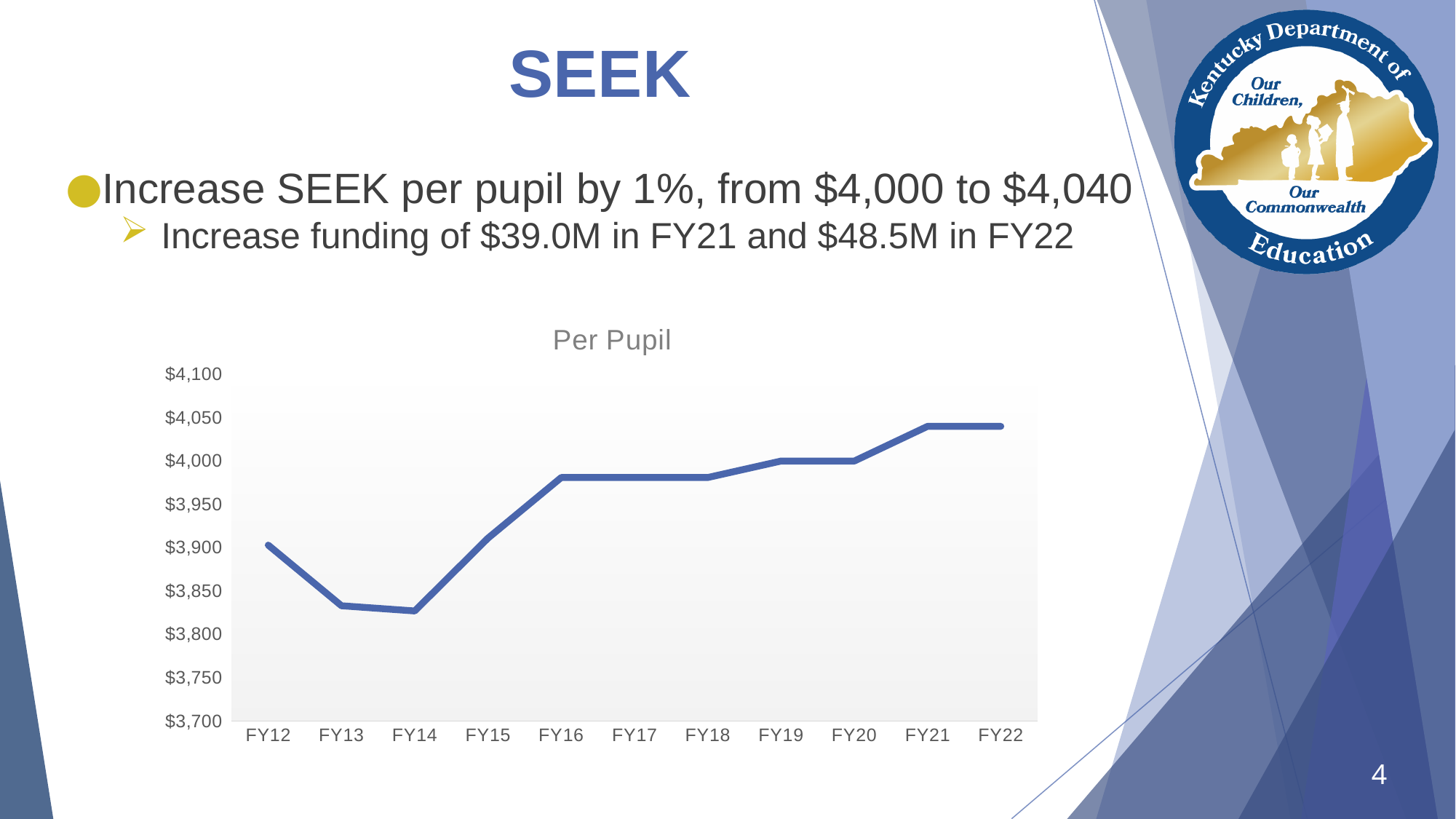
Is the per pupil value for FY16 greater or less than $3,950? greater Is the per pupil value for FY18 greater or less than $4,000? less What is the title of the chart? Per Pupil Is the per pupil value for FY21 greater or less than $4,000? greater Which has the higher per pupil value, FY12 or FY13? FY12 Which has the higher per pupil value, FY22 or FY12? FY22 How many fiscal years are plotted on the x axis of the chart? 11 What is the per pupil value for FY20? $4,000 What kind of chart is shown on the slide? line chart Overall, does the per pupil value rise or fall from FY14 to FY22? rise